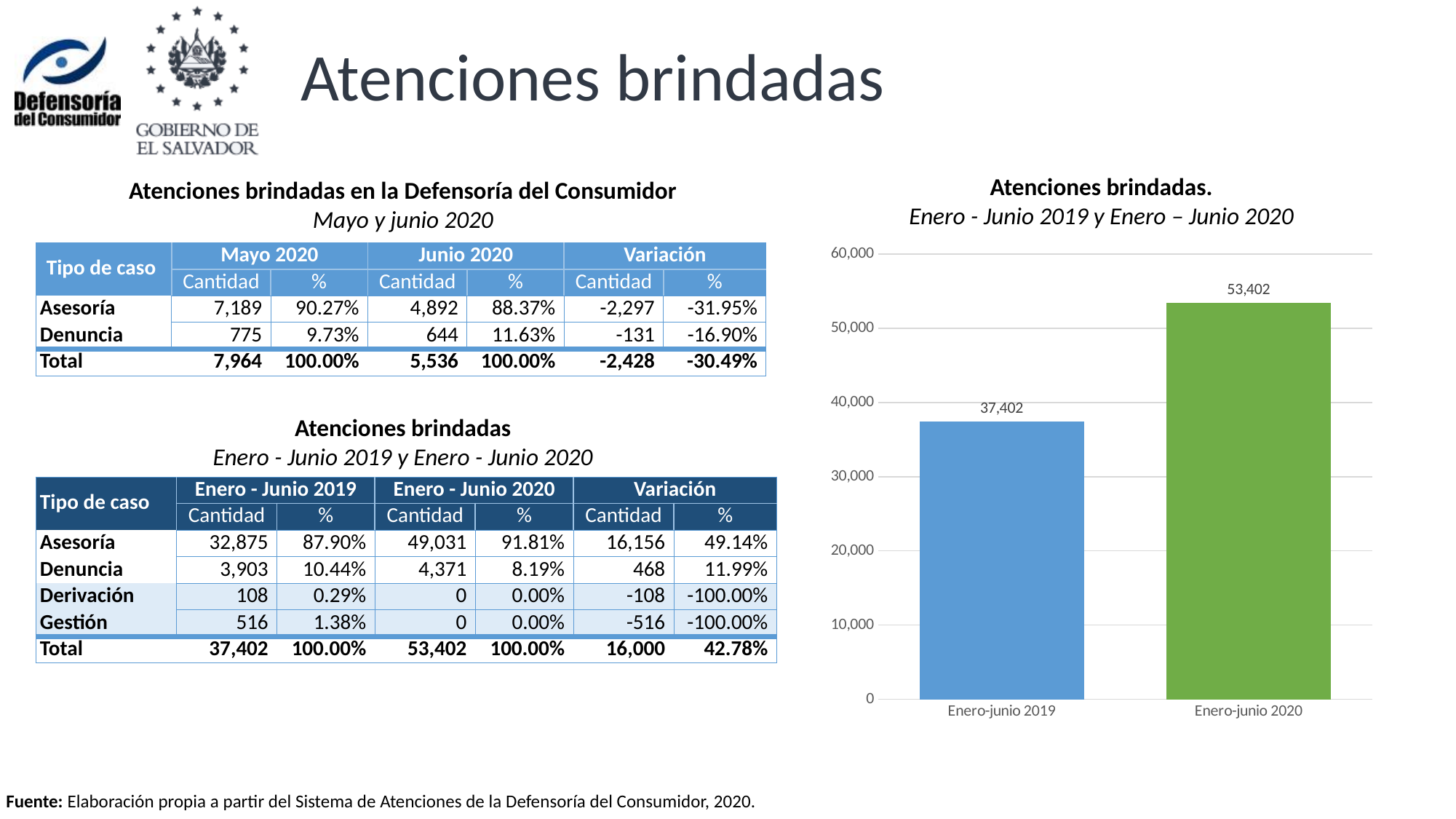
What colour is the bar for Enero-junio 2020? green Do the values rise or fall from Enero-junio 2019 to Enero-junio 2020? rise Is the value for Enero-junio 2019 greater or less than 40,000? less What is the title of the chart? Atenciones brindadas. Enero - Junio 2019 y Enero – Junio 2020 How many bars are plotted in the chart? 2 What is the difference between the values for Enero-junio 2020 and Enero-junio 2019 in the chart? 16,000 Which period has the higher value in the chart? Enero-junio 2020 What is the value for Enero-junio 2019 in the chart? 37,402 Is the value for Enero-junio 2020 greater or less than 50,000? greater What kind of chart is shown on the slide? bar chart What is the value for Enero-junio 2020 in the chart? 53,402 Which period has the lower value in the chart? Enero-junio 2019